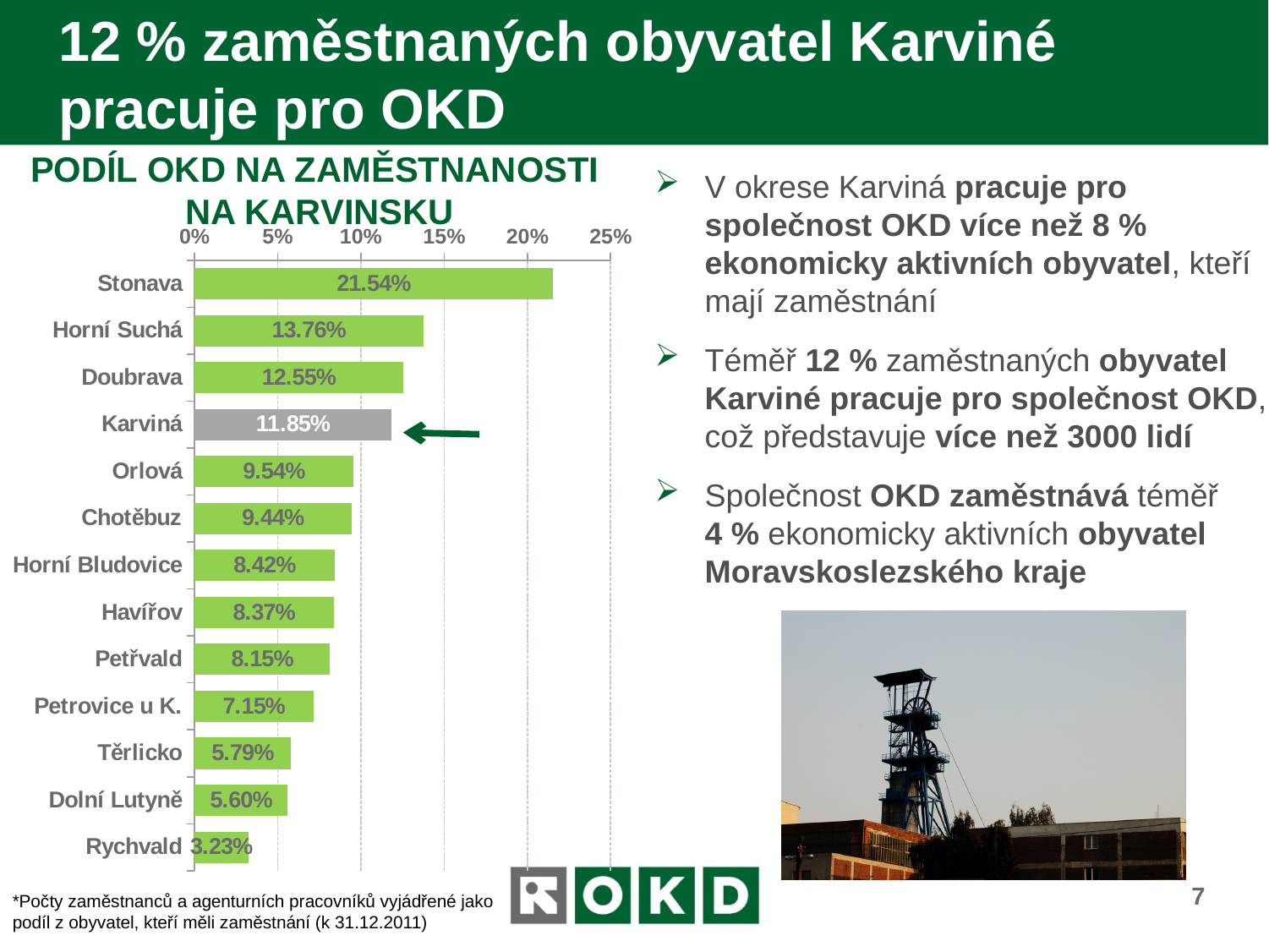
What is the value for Stonava? 21.54% Which municipality has the highest share? Stonava What kind of chart is shown on the slide? Bar chart Which municipality has the lowest share? Rychvald What is the value for Dolní Lutyně? 5.60% Which bar is coloured grey instead of green? Karviná Which is larger, the value for Doubrava or the value for Karviná? Doubrava What is the value for Karviná? 11.85% What is the difference between the values for Stonava and Horní Suchá? 7.78% Is the value for Stonava greater or less than 20%? greater What is the difference between the values for Karviná and Rychvald? 8.62% How many municipalities are shown in the chart? 13